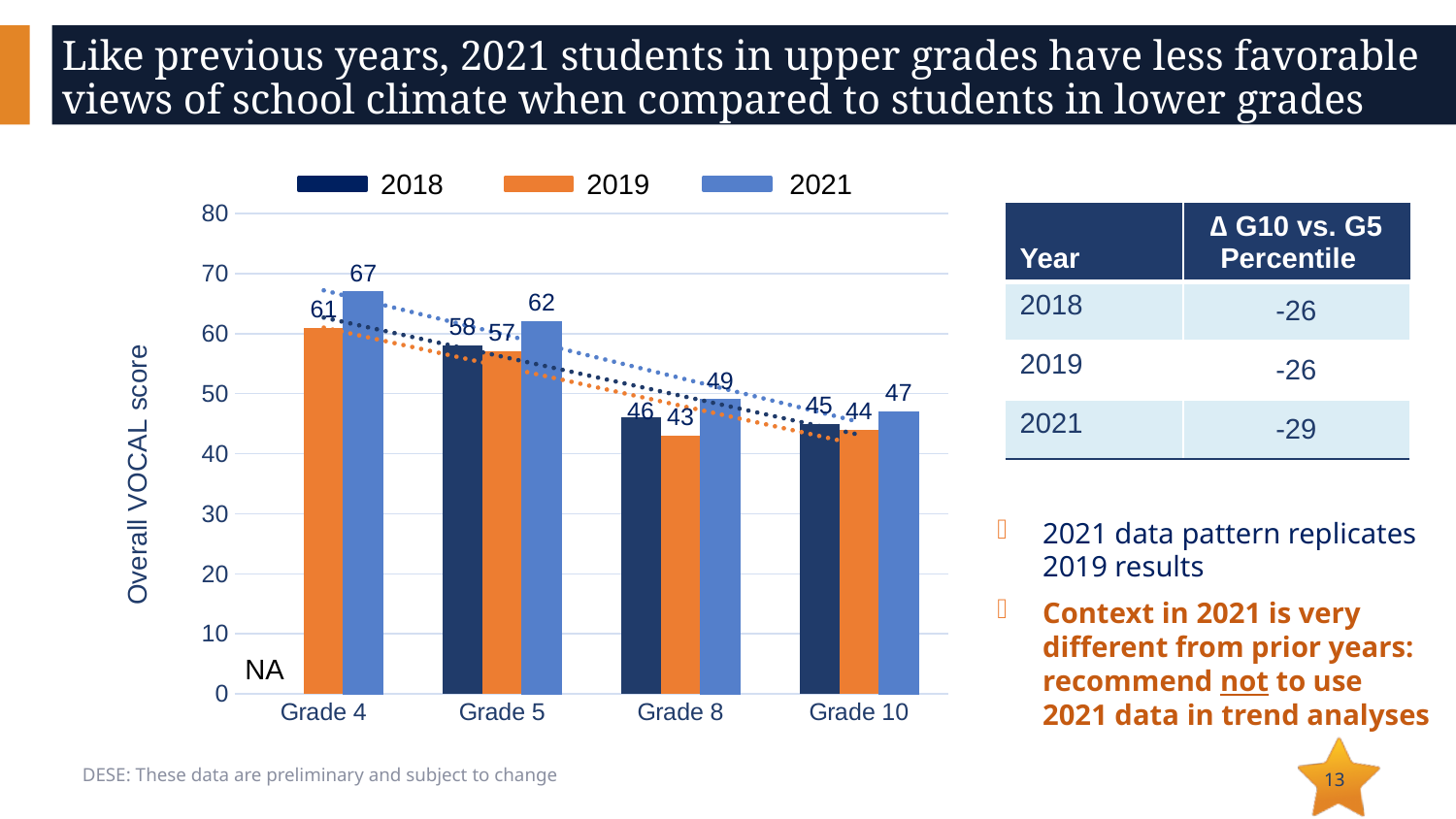
Do the 2021 Overall VOCAL scores rise or fall from Grade 4 to Grade 10? Fall Which grade has the lowest 2019 Overall VOCAL score? Grade 8 How many series does the legend list? 3 How many grade categories are shown on the x axis? 4 What is the 2018 Overall VOCAL score for Grade 10? 45 Which grade has the highest 2021 Overall VOCAL score? Grade 4 What is the 2021 Overall VOCAL score for Grade 4? 67 What is the 2019 Overall VOCAL score for Grade 8? 43 Which is larger, the 2018 score for Grade 5 or the 2018 score for Grade 8? 2018 score for Grade 5 What is the difference between the 2021 and 2019 Overall VOCAL scores for Grade 5? 5 What is the label on the y axis of the chart? Overall VOCAL score What kind of chart is shown on the slide? Bar chart